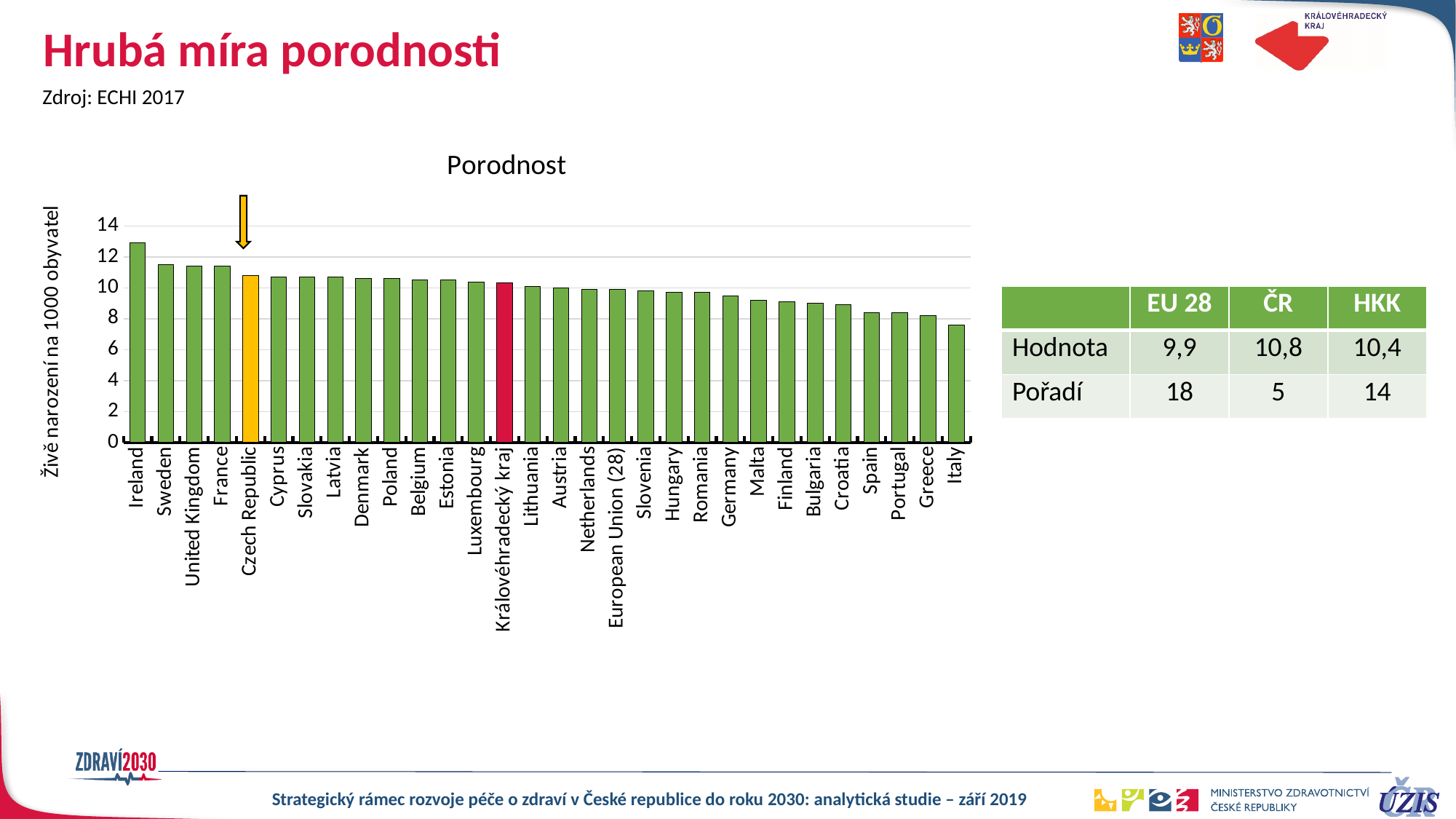
What type of chart is shown on the slide? bar chart Is the value for Ireland greater or less than 12? greater Do the values rise or fall from left to right along the x axis? fall What is the title of the chart? Porodnost What colour is the bar for Královéhradecký kraj? red Which country has the lowest value in the chart? Italy Which country has the highest value in the chart? Ireland Which has a larger value, Sweden or Greece? Sweden How many bars are plotted in the chart? 30 Is the value for Italy greater or less than 8? less What is the difference between the values for ČR and HKK shown in the table? 0,4 What is the value for the Czech Republic (ČR) according to the table? 10,8